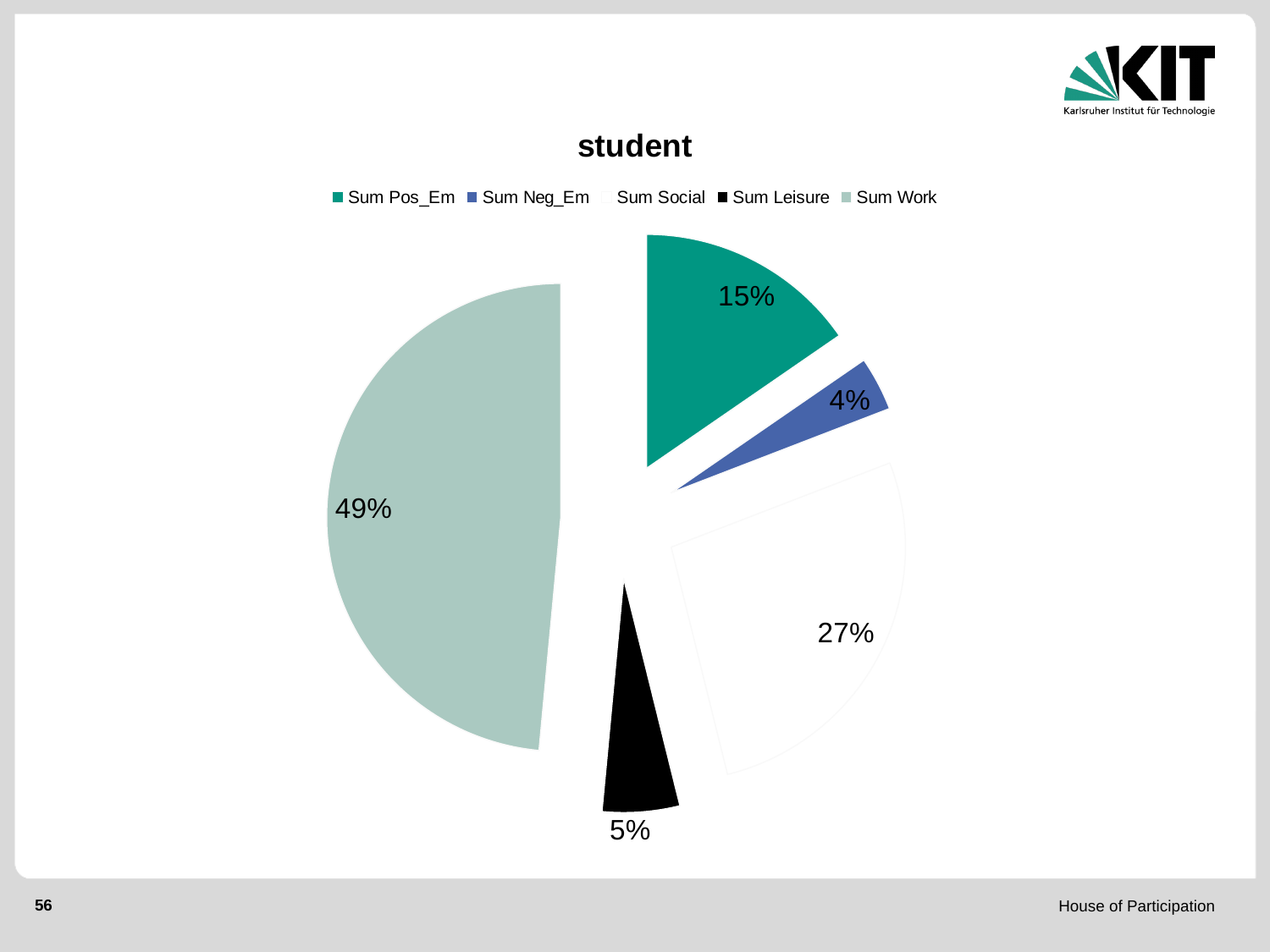
What kind of chart is shown on the slide? Pie chart What is the value for Sum Leisure? 5% Which is larger, Sum Pos_Em or Sum Leisure? Sum Pos_Em What is the value for Sum Pos_Em? 15% What share of the pie does Sum Work represent? 49% What is the title of the chart? student What is the difference between the Sum Work and Sum Social shares? 22% How many categories does the pie chart show? 5 Which category has the largest slice of the pie? Sum Work What is the value for Sum Neg_Em? 4% Which category has the smallest slice of the pie? Sum Neg_Em What is the value for Sum Social? 27%